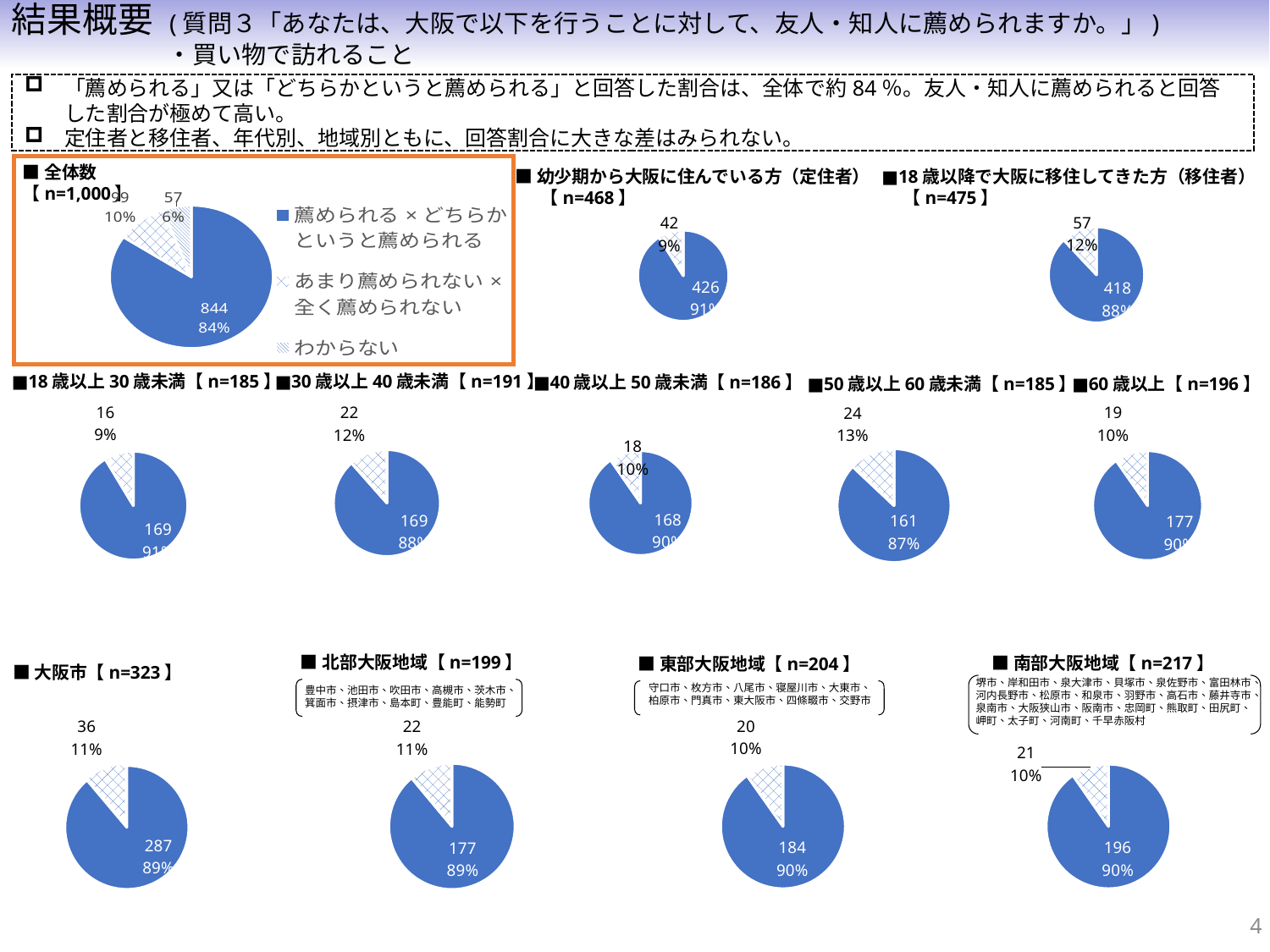
Which is larger: the smaller slice in the 定住者【n=468】 pie chart (42) or the smaller slice in the 移住者【n=475】 pie chart (57)? 移住者 (57) How many entries does the legend of the 全体数【n=1,000】 pie chart list? 3 In the 18歳以降で大阪に移住してきた方（移住者）【n=475】 pie chart, what is the value of the smaller slice? 57 In the 大阪市【n=323】 pie chart, what percentage is shown for the smaller slice? 11% In the 50歳以上60歳未満【n=185】 pie chart, what is the value of the larger slice? 161 What kind of chart is used for the 全体数【n=1,000】 data on the slide? pie chart What is the difference between the larger slice values of the 60歳以上【n=196】 pie chart (177) and the 50歳以上60歳未満【n=185】 pie chart (161)? 16 In the 南部大阪地域【n=217】 pie chart, what is the value of the larger slice? 196 How many pie charts are shown in the bottom row (地域別) of the slide? 4 In the 全体数【n=1,000】 pie chart, what is the value for 薦められる×どちらかというと薦められる? 844 In the 全体数【n=1,000】 pie chart, what share of the pie is わかからない (the 57 slice)? 6% In the 幼少期から大阪に住んでいる方（定住者）【n=468】 pie chart, what percentage is shown for the larger slice? 91%